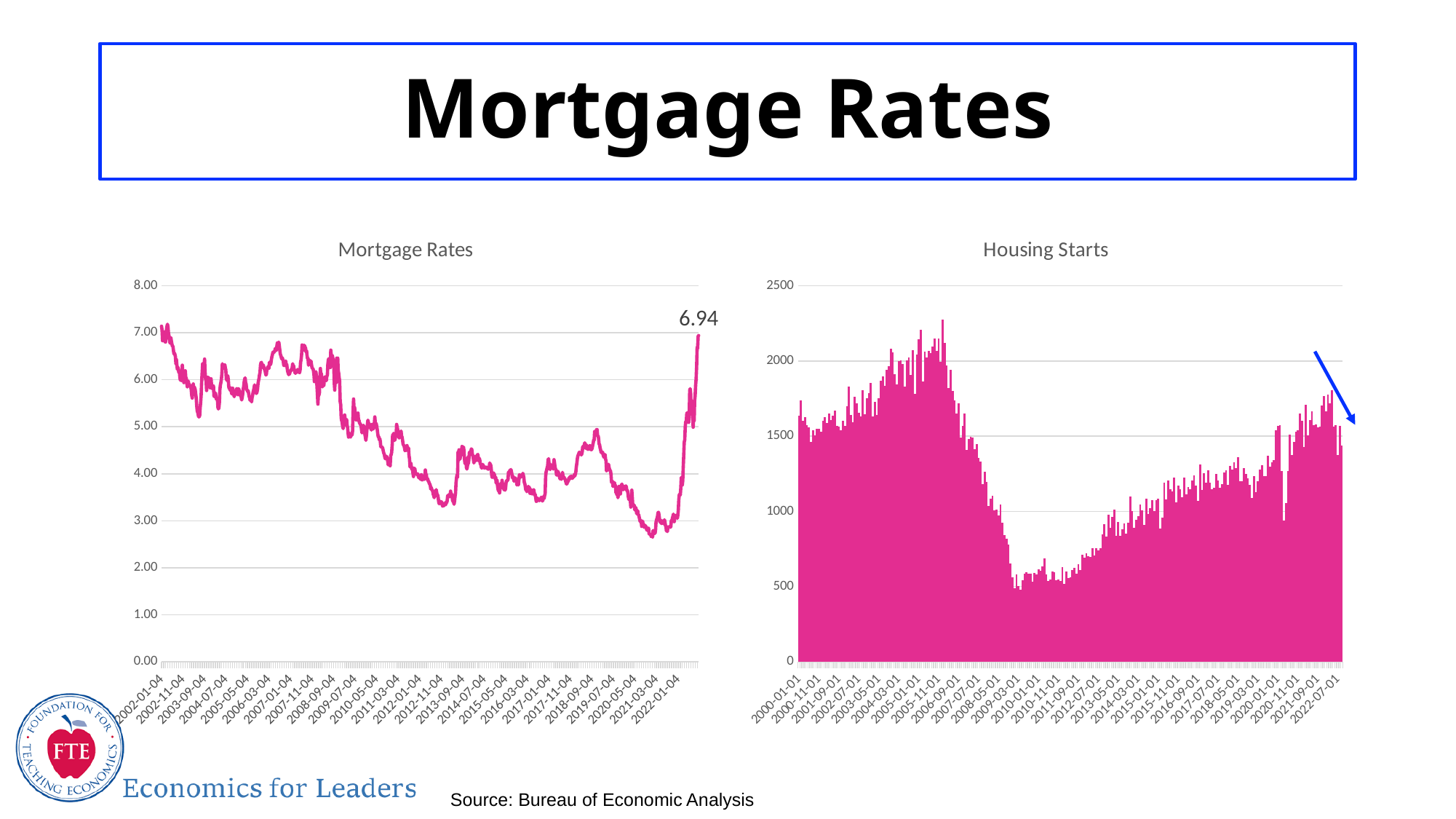
What kind of chart is the Mortgage Rates chart? line chart On the Housing Starts chart, do the values generally rise or fall from 2009 to 2022? rise On the Housing Starts chart, is the highest value greater or less than 2000? greater On the Housing Starts chart, is the value around 2009-03-01 greater or less than 1000? less What is the highest value shown on the y-axis of the Housing Starts chart? 2500 On the Mortgage Rates chart, is the final value (6.94) higher or lower than the values around 2012? higher On the Mortgage Rates chart, do the values generally rise or fall from 2002 to 2021? fall On the Mortgage Rates chart, is the lowest point of the line greater or less than 3.00? less On the Mortgage Rates chart, what value is labeled at the end of the line? 6.94 On the Housing Starts chart, which is higher: the value around 2005 or the value around 2010? 2005 How many charts are shown on the slide? 2